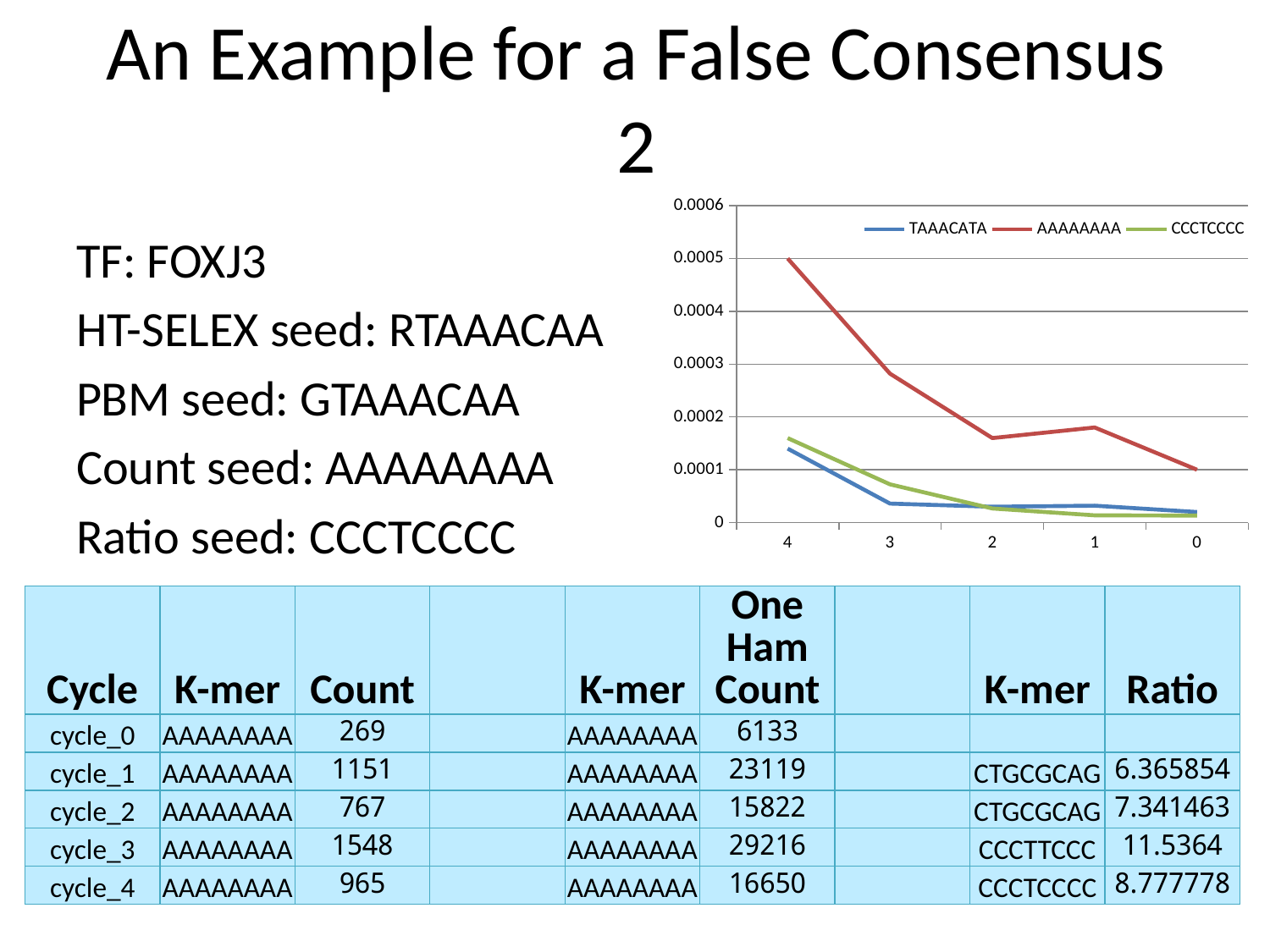
At x = 4, which series has the larger value, AAAAAAAA or TAAACATA? AAAAAAAA Which series has the highest values in the chart? AAAAAAAA Is the value for AAAAAAAA at x = 2 greater or less than 0.0002? less How many points are plotted along the x axis of the chart? 5 What kind of chart is shown on the slide? line chart Is the value for CCCTCCCC at x = 4 greater or less than 0.0001? greater Which series is drawn in green in the chart? CCCTCCCC Is the value for TAAACATA at x = 4 greater or less than 0.0002? less What colour is the line for AAAAAAAA in the chart? red Do the values for AAAAAAAA rise or fall moving from x = 4 to x = 2? fall How many series does the chart legend list? 3